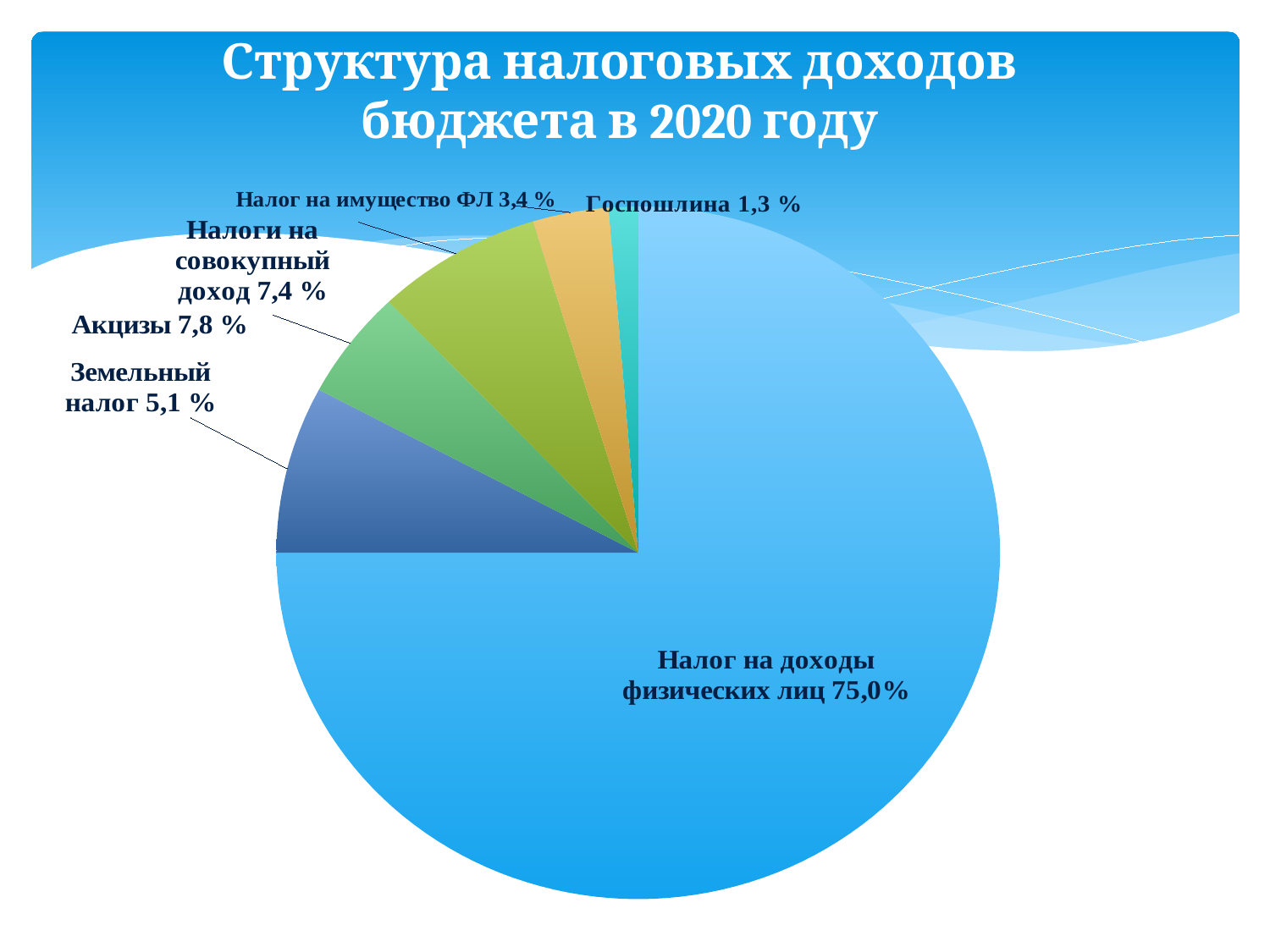
Which category has the largest slice of the pie? Налог на доходы физических лиц What is the difference between the shares of "Акцизы" and "Налог на имущество ФЛ"? 4,4 % What is the value shown for "Госпошлина"? 1,3 % What share of tax revenues does "Налог на доходы физических лиц" account for? 75,0 % Which category has the smallest slice of the pie? Госпошлина What is the value shown for "Земельный налог"? 5,1 % What is the value shown for "Акцизы"? 7,8 % What is the value shown for "Налоги на совокупный доход"? 7,4 % What is the title of the chart on the slide? Структура налоговых доходов бюджета в 2020 году Which is larger, the share of "Земельный налог" or the share of "Налог на имущество ФЛ"? Земельный налог What kind of chart is shown on the slide? Pie chart How many slices does the pie chart have? 6